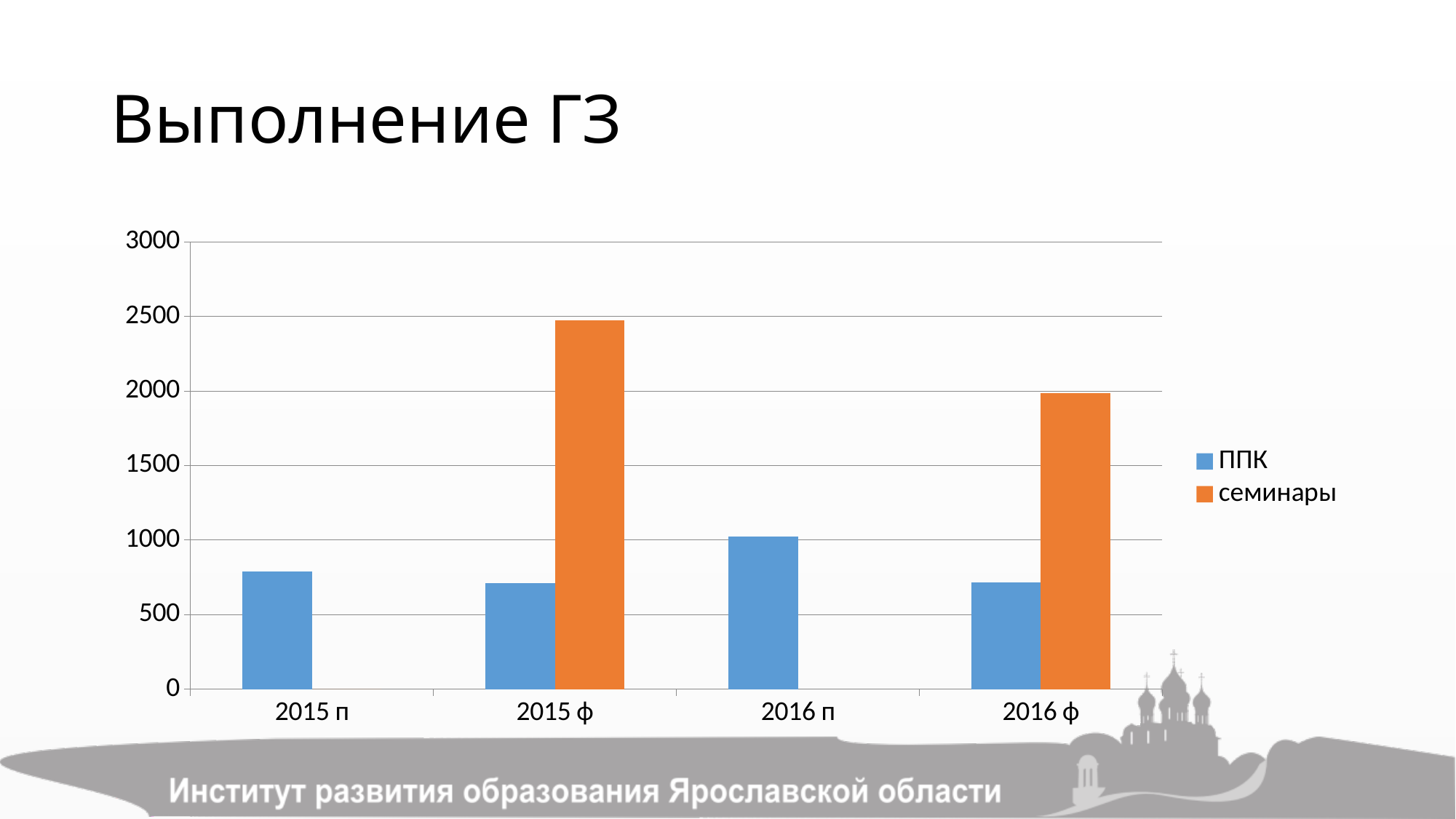
Which category has the highest value for ППК? 2016 п Which category has the highest value for семинары? 2015 ф What kind of chart is shown on the slide? bar chart Is the value for семинары in 2016 ф greater or less than 2500? less How many categories are shown on the x axis? 4 Which colour represents the семинары series? orange Is the value for семинары in 2015 ф greater or less than 2000? greater How many series does the legend list? 2 Which is larger: семинары in 2015 ф or семинары in 2016 ф? 2015 ф Is the value for ППК in 2016 п greater or less than 500? greater What is the title of the chart on the slide? Выполнение ГЗ